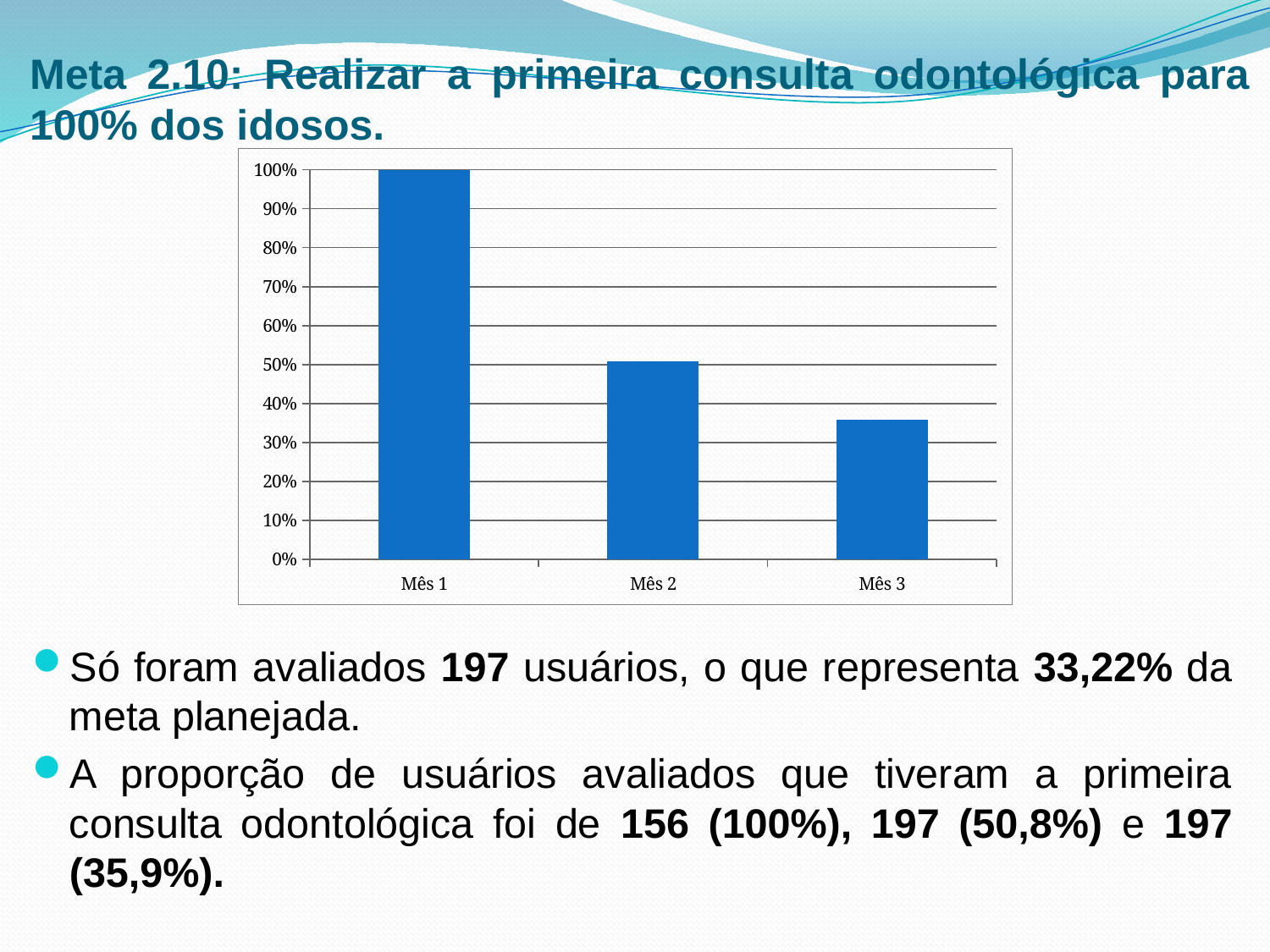
How many categories (bars) are shown in the chart? 3 Is the value for Mês 2 greater or less than 60%? less Which is larger, the value for Mês 2 or the value for Mês 3? Mês 2 Is the value for Mês 3 greater or less than 40%? less What kind of chart is shown on the slide? bar chart Which month has the lowest value in the chart? Mês 3 Do the values rise or fall from Mês 1 to Mês 3? fall What is the highest tick shown on the vertical axis of the chart? 100% Is the value for Mês 3 greater or less than 30%? greater What is the value for Mês 1 in the chart? 100% Which month has the highest value in the chart? Mês 1